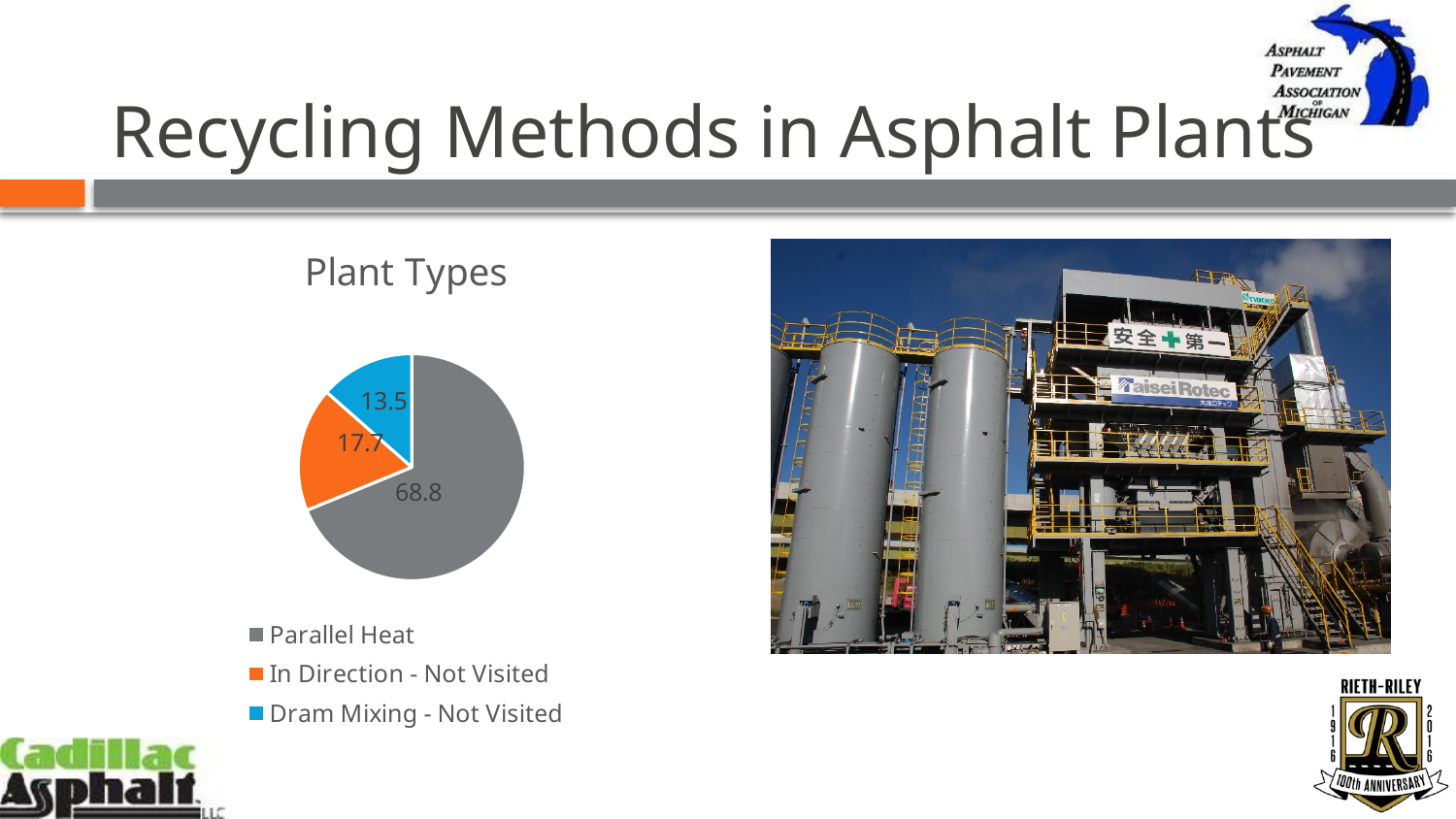
Which category has the smallest slice in the Plant Types pie chart? Dram Mixing - Not Visited What is the value for Parallel Heat in the Plant Types pie chart? 68.8 What type of chart is shown under the title "Plant Types"? Pie chart In the Plant Types pie chart, which is larger: In Direction - Not Visited or Dram Mixing - Not Visited? In Direction - Not Visited What is the difference between the values for In Direction - Not Visited and Dram Mixing - Not Visited in the Plant Types pie chart? 4.2 What is the value for Dram Mixing - Not Visited in the Plant Types pie chart? 13.5 What colour is the Parallel Heat slice in the Plant Types pie chart? Gray How many slices does the Plant Types pie chart have? 3 What is the difference between the values for Parallel Heat and In Direction - Not Visited in the Plant Types pie chart? 51.1 What is the value for In Direction - Not Visited in the Plant Types pie chart? 17.7 What is the title of the pie chart on the slide? Plant Types Which category has the largest slice in the Plant Types pie chart? Parallel Heat